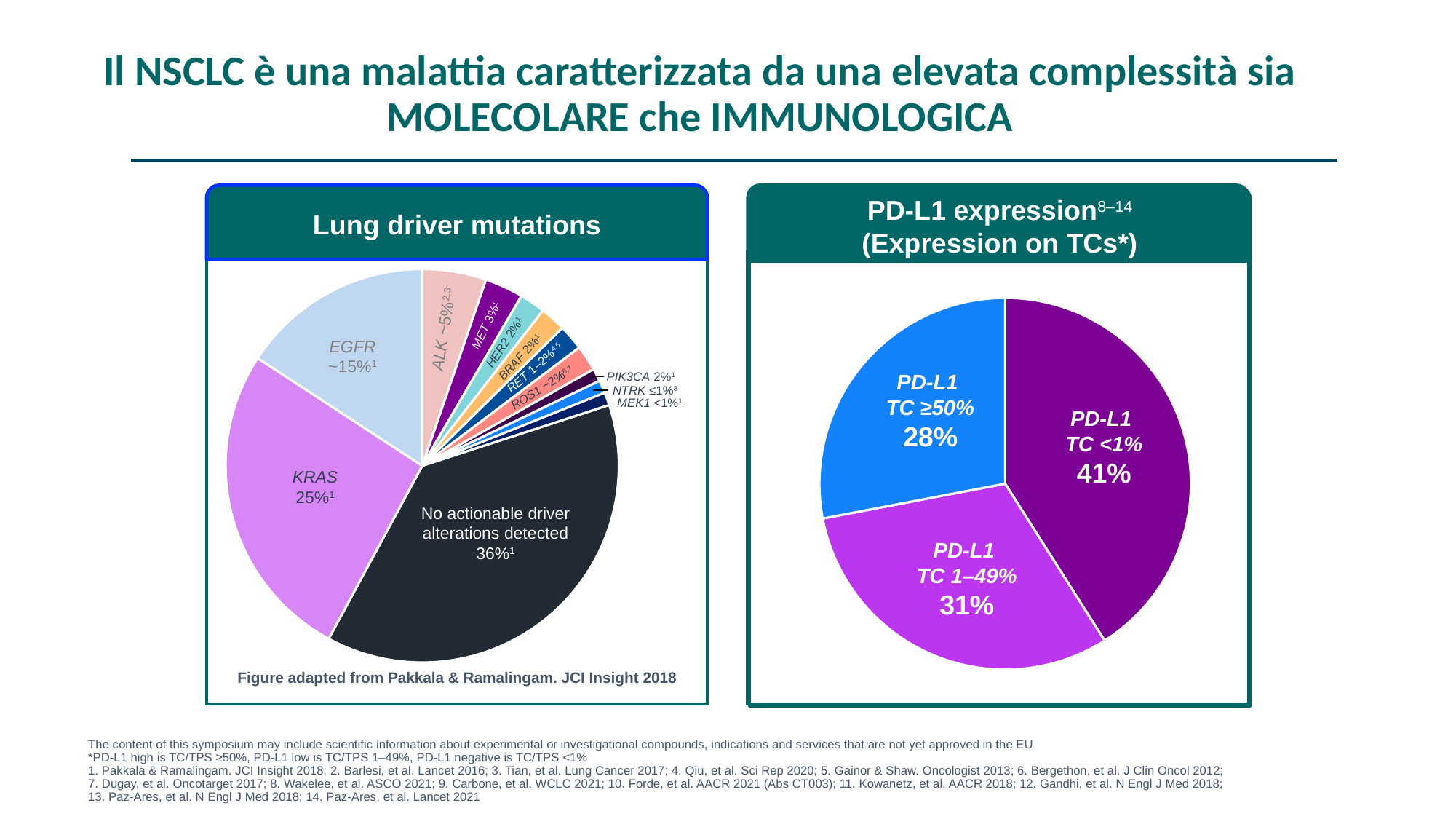
In the 'Lung driver mutations' chart, what value is shown for EGFR? ~15% In the 'Lung driver mutations' chart, what is the difference between the 'No actionable driver alterations detected' slice and the KRAS slice? 11 percentage points In the 'PD-L1 expression' chart, what percentage is shown for PD-L1 TC <1%? 41% In the 'Lung driver mutations' chart, which is larger, KRAS or EGFR? KRAS In the 'Lung driver mutations' chart, what percentage is shown for KRAS? 25% In the 'PD-L1 expression' chart, which category has the smallest share? PD-L1 TC ≥50% In the 'PD-L1 expression' chart, what is the difference between the PD-L1 TC <1% slice and the PD-L1 TC ≥50% slice? 13 percentage points In the 'Lung driver mutations' chart, what value is shown for MET? 3% How many slices does the 'Lung driver mutations' pie chart have? 12 In the 'Lung driver mutations' chart, what percentage is shown for 'No actionable driver alterations detected'? 36% In the 'Lung driver mutations' chart, which slice is the largest? No actionable driver alterations detected In the 'PD-L1 expression' chart, what percentage is shown for PD-L1 TC 1–49%? 31%